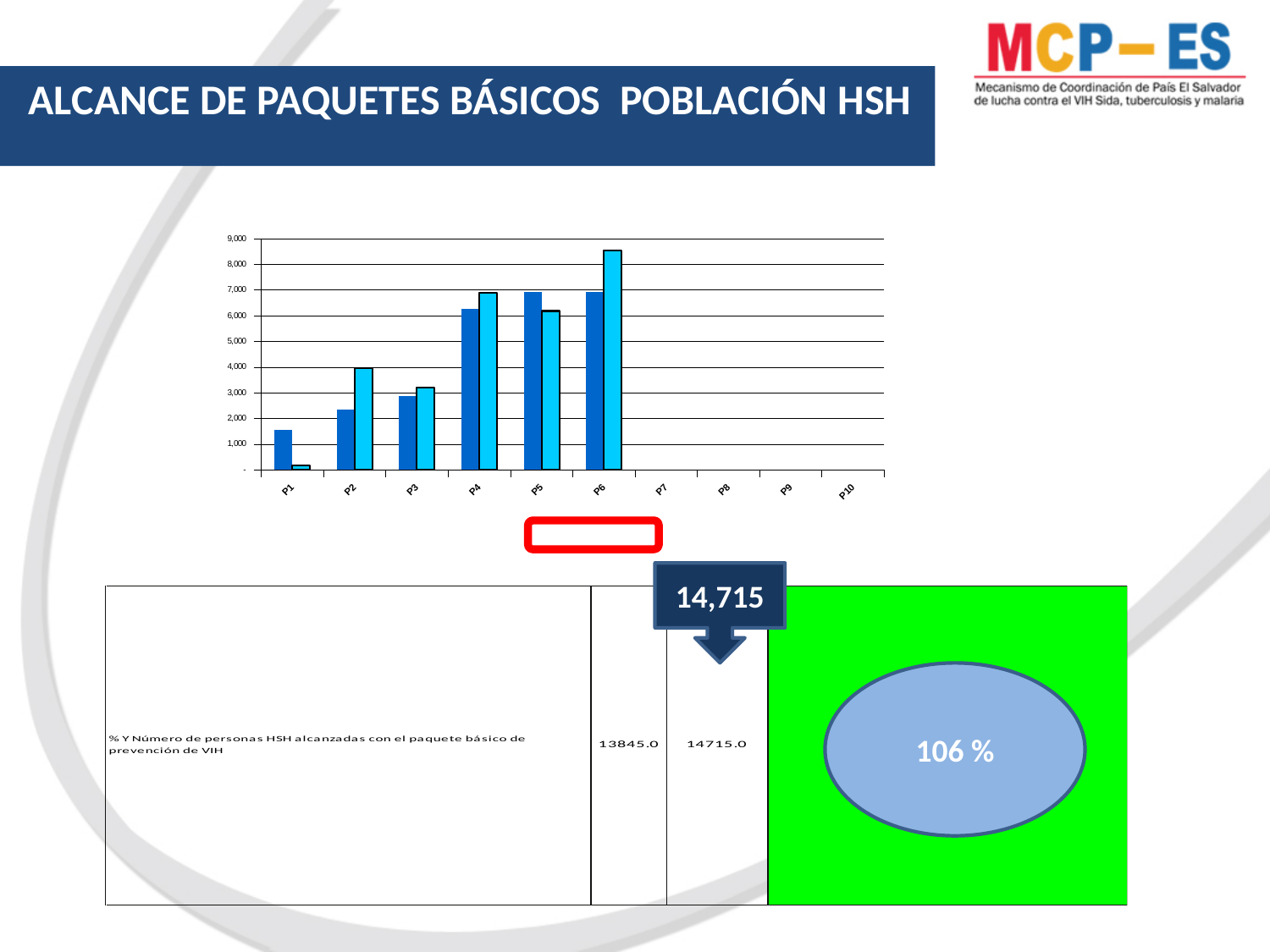
What kind of chart is shown on the slide? bar chart Do the dark blue bars generally rise or fall from P1 to P6? rise How many categories on the x axis have no bars plotted? 4 Which category has the shortest dark blue bar in the chart? P1 Is the light blue bar for P4 greater or less than 6,000? greater Is the dark blue bar for P3 greater or less than 4,000? less How many categories are labelled on the x axis of the chart? 10 Is the light blue bar for P6 greater or less than 8,000? greater Which category has the tallest bar in the chart? P6 For P5, which bar is taller, the dark blue one or the light blue one? dark blue For P2, which bar is taller, the dark blue one or the light blue one? light blue